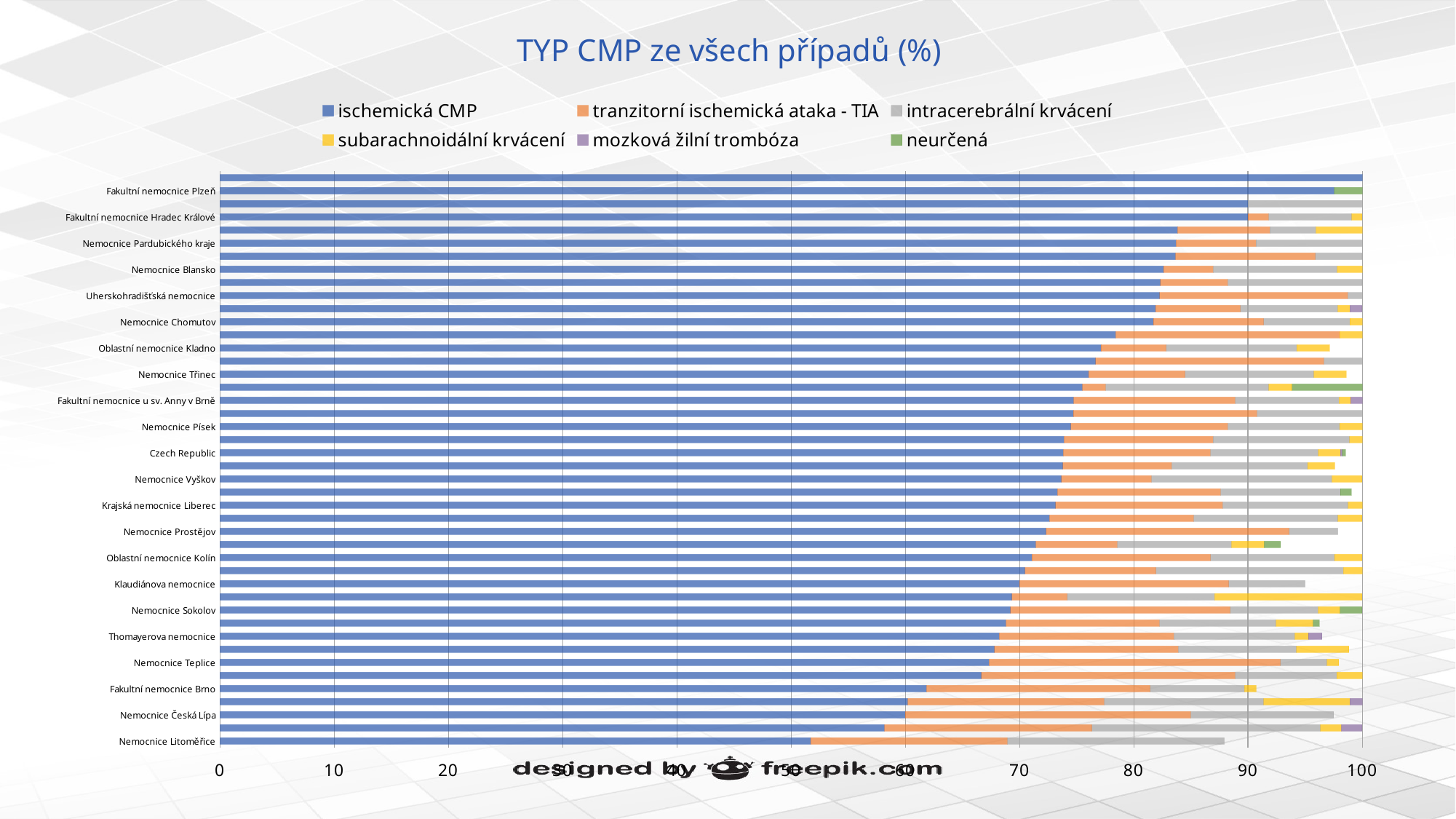
Is the ischemická CMP value for Czech Republic greater or less than 70? greater Which has a larger ischemická CMP share, Czech Republic or Nemocnice Litoměřice? Czech Republic Is the ischemická CMP value for Nemocnice Pardubického kraje greater or less than 80? greater What is the title of the chart? TYP CMP ze všech případů (%) Which category has the lowest share of ischemická CMP? Nemocnice Litoměřice How many series does the legend list? 6 What kind of chart is shown on the slide? stacked bar chart Going down the chart from Fakultní nemocnice Plzeň to Nemocnice Litoměřice, does the ischemická CMP share rise or fall? fall Is the ischemická CMP value for Nemocnice Litoměřice greater or less than 60? less Which colour represents the series 'ischemická CMP' in the legend? blue